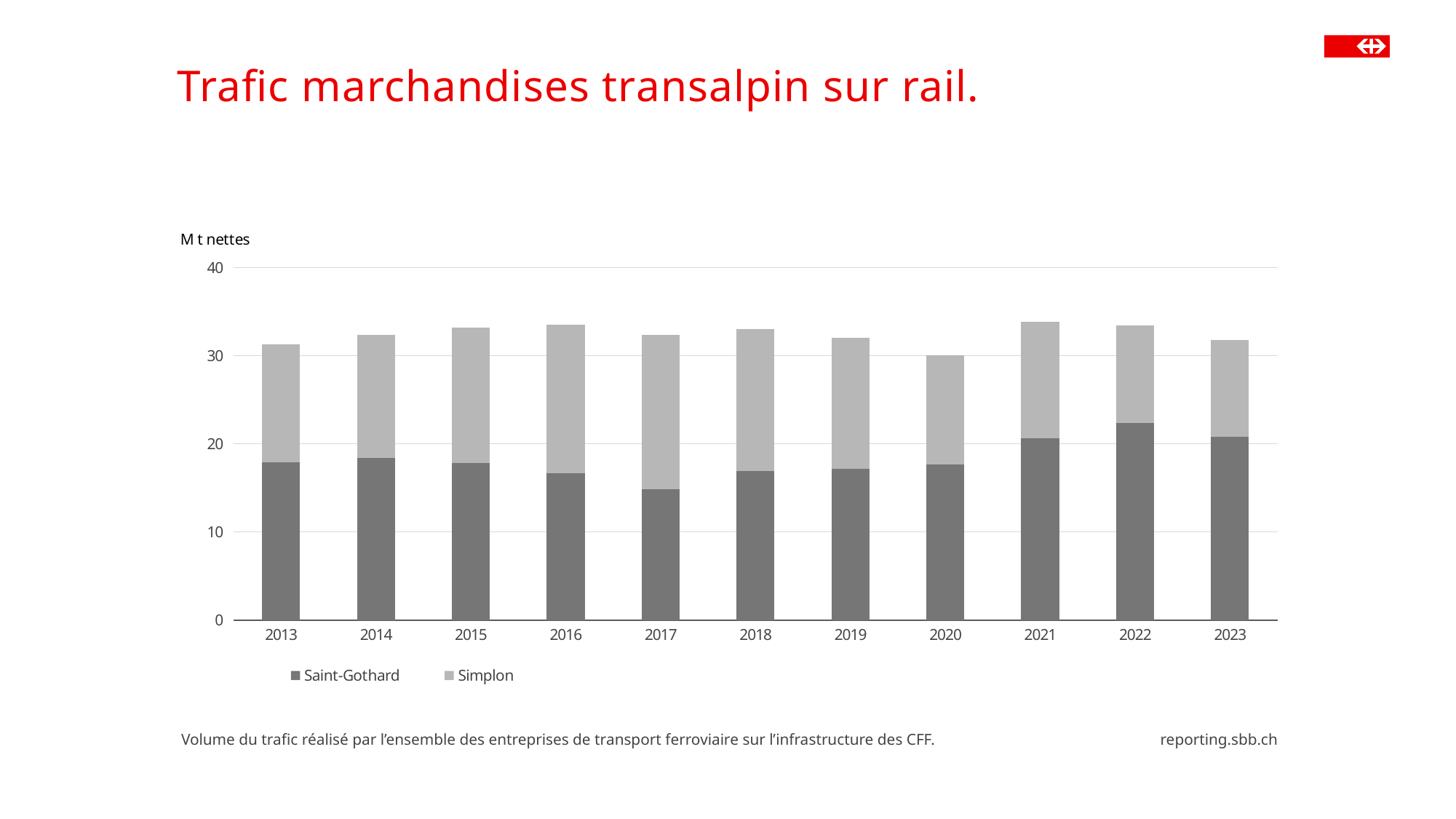
How many series does the legend list? 2 Is the Saint-Gothard value for 2017 greater or less than 20? less Which year has the larger Saint-Gothard value, 2017 or 2022? 2022 In which year is the Saint-Gothard value the highest? 2022 What kind of chart is shown on the slide? Stacked bar chart How many years are shown on the x axis? 11 Is the Saint-Gothard value for 2022 greater or less than 20? greater In which year is the total stacked bar the lowest? 2020 What unit is given for the y axis? M t nettes Which series is shown in the darker grey? Saint-Gothard Is the total stacked bar for 2021 greater or less than 30? greater In which year is the Saint-Gothard value the lowest? 2017